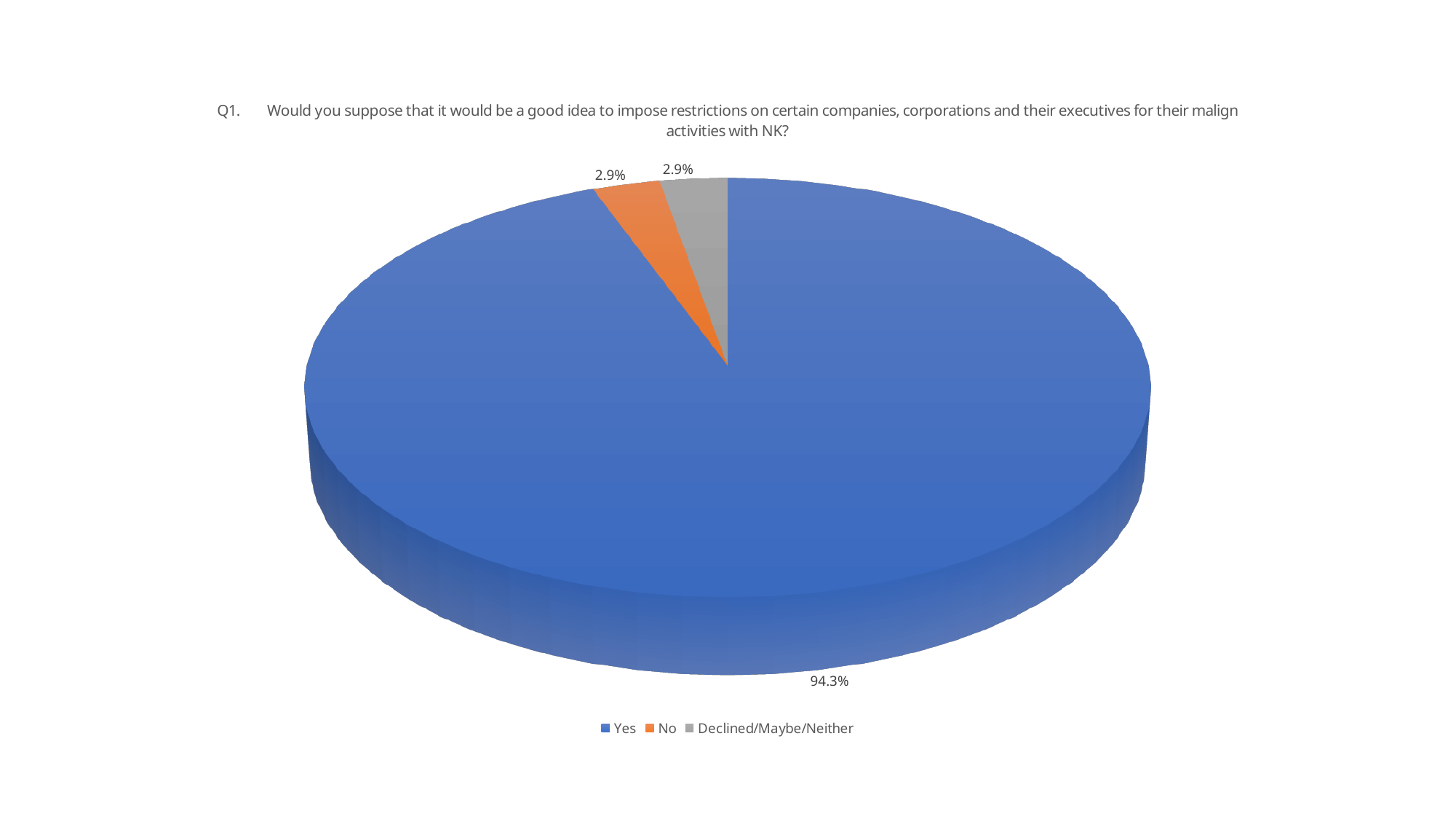
What is the difference between the Yes share and the No share? 91.4% What share of respondents answered No? 2.9% What is the combined share of No and Declined/Maybe/Neither? 5.8% How many slices does the pie chart have? 3 What colour is the No slice? orange How many entries does the legend list? 3 What share of respondents answered Declined/Maybe/Neither? 2.9% What kind of chart is shown on the slide? pie chart Which response has the largest share of the pie? Yes What share of respondents answered Yes? 94.3% What colour is the Yes slice? blue Which is larger, the share for Yes or the share for No? Yes